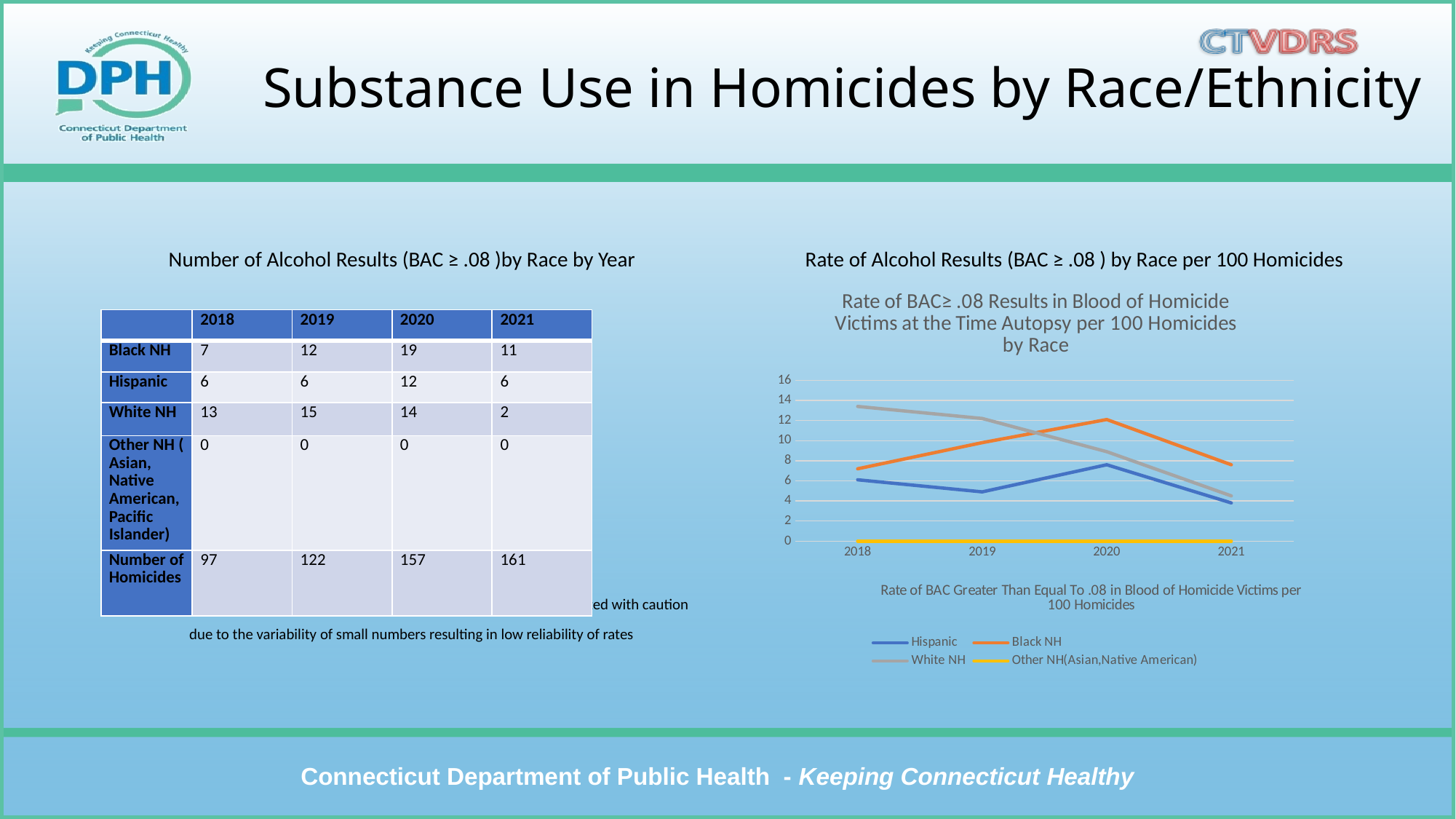
In the line chart on the right, is the White NH rate in 2021 greater or less than 6? less In the line chart on the right, is the Black NH rate in 2020 greater or less than 10? greater In the line chart on the right, does the White NH rate rise or fall from 2018 to 2021? fall What kind of chart is the 'Rate of BAC≥ .08 Results in Blood of Homicide Victims' chart on the right? line chart In the line chart on the right, is the Hispanic rate in 2019 greater or less than 6? less In the line chart on the right, which race has the highest rate in 2018? White NH In the line chart on the right, which race has the lowest rate in every year? Other NH(Asian,Native American) How many series does the legend of the line chart on the right list? 4 In the line chart on the right, which race has the highest rate in 2020? Black NH How many years are plotted along the x axis of the line chart on the right? 4 In the line chart on the right, which is larger in 2021: the Black NH rate or the Hispanic rate? Black NH